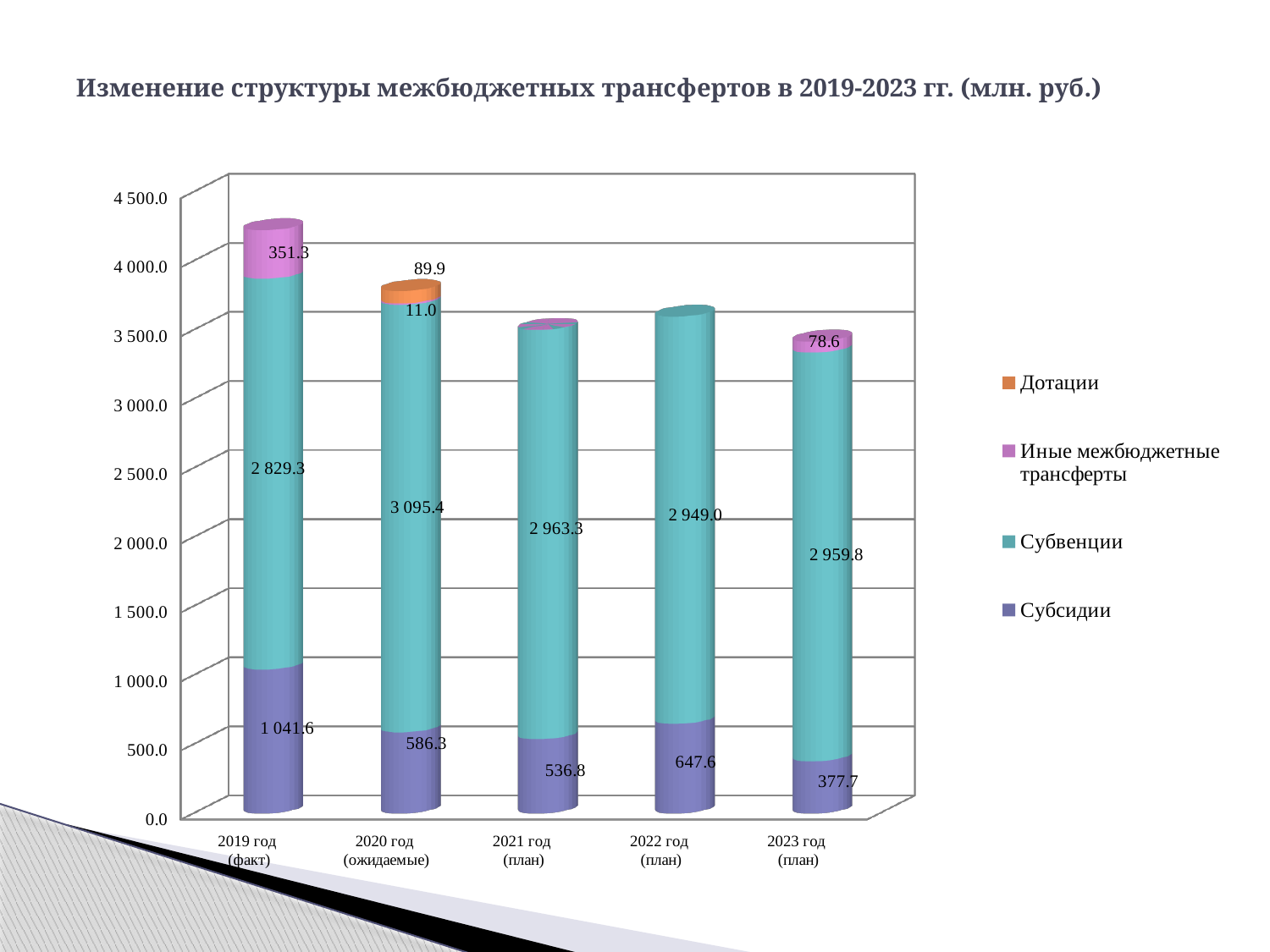
How many series does the legend list? 4 What is the value of Дотации for 2020 год (ожидаемые)? 89.9 Which year has the lowest Субсидии value? 2023 год (план) What is the value of Субвенции for 2020 год (ожидаемые)? 3 095.4 What is the difference between the Субсидии values for 2022 год (план) and 2021 год (план)? 110.8 Which is larger, the Субвенции value for 2021 год (план) or for 2022 год (план)? 2021 год (план) Which year has the highest Субвенции value? 2020 год (ожидаемые) What is the value of Иные межбюджетные трансферты for 2023 год (план)? 78.6 What is the value of Субсидии for 2019 год (факт)? 1 041.6 How many year categories are shown on the x axis? 5 What is the title of the chart? Изменение структуры межбюджетных трансфертов в 2019-2023 гг. (млн. руб.) What type of chart is shown on the slide? stacked bar chart